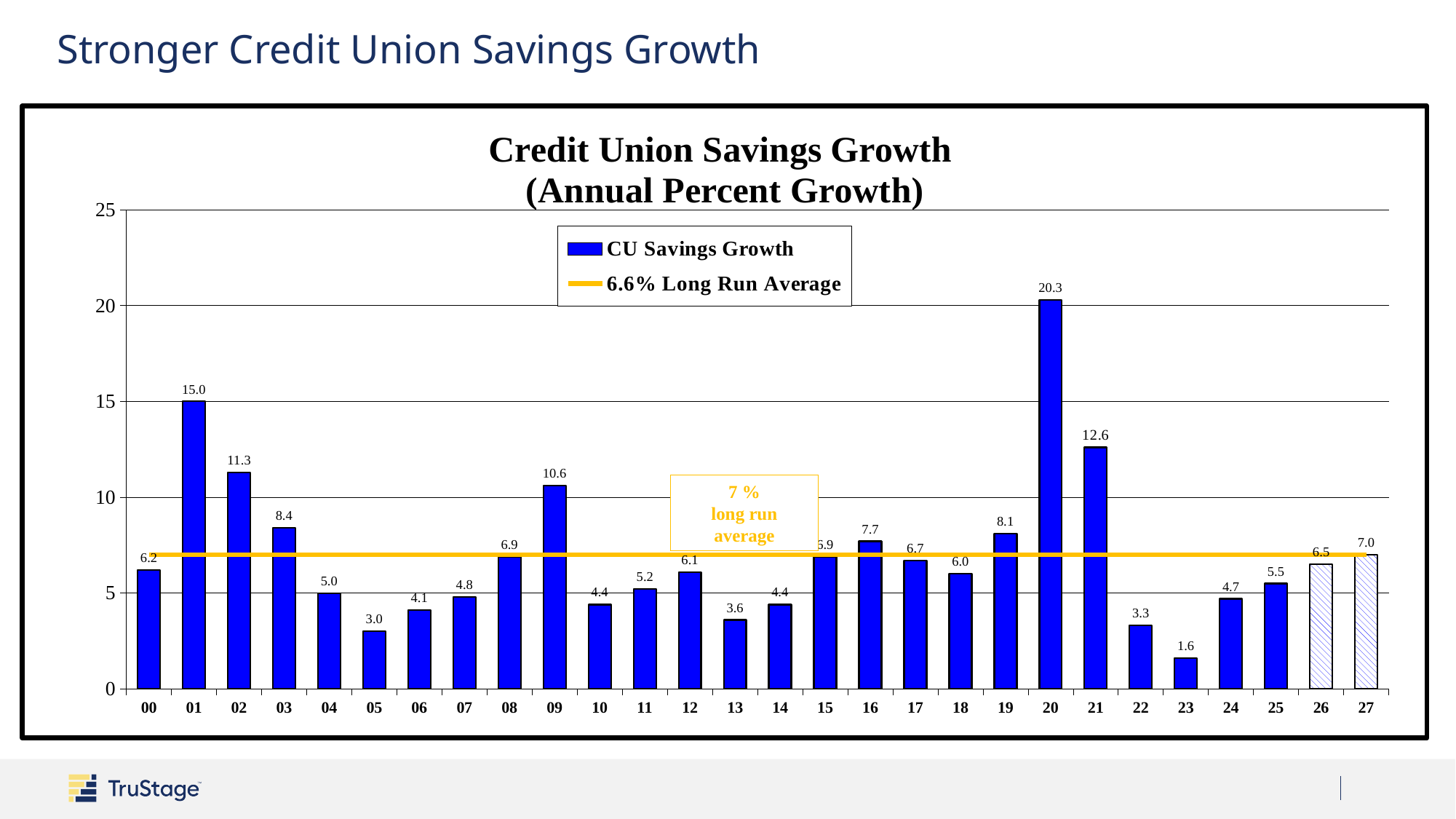
What is the CU Savings Growth value for 23? 1.6 Is the CU Savings Growth value for 21 greater or less than 10? greater What kind of chart is used to show CU Savings Growth? Bar chart Which year has the highest CU Savings Growth? 20 How many years are shown on the x axis of the chart? 28 How many entries does the chart legend list? 2 What is the difference between the CU Savings Growth values for 01 and 00? 8.8 What is the CU Savings Growth value for 20? 20.3 Which year has the lowest CU Savings Growth? 23 What is the CU Savings Growth value for 09? 10.6 Which year has a larger CU Savings Growth value, 01 or 02? 01 What is the difference between the CU Savings Growth values for 20 and 21? 7.7